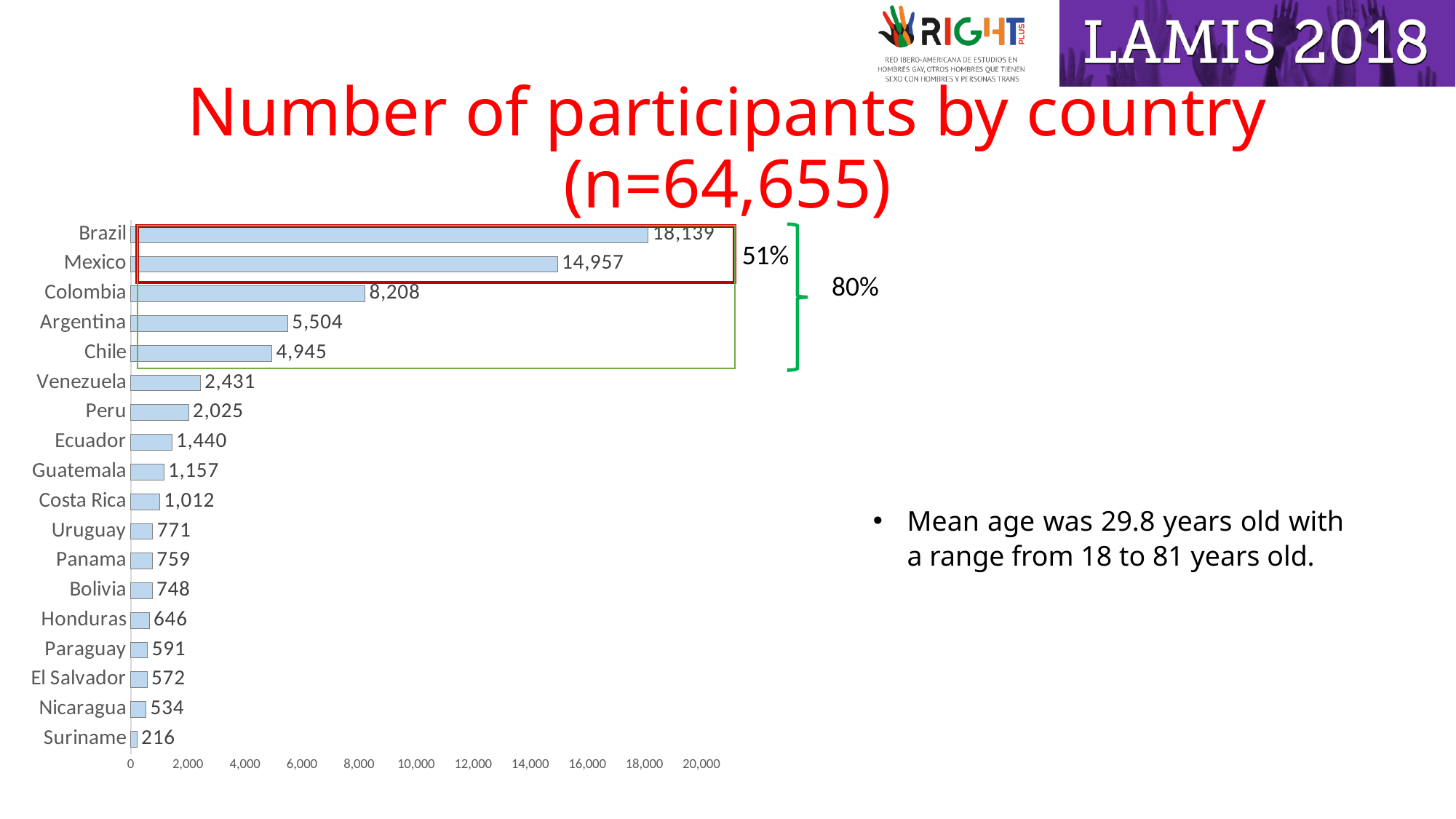
What is the number of participants for Colombia? 8,208 What is the difference in participants between Brazil and Mexico? 3,182 Which country has the lowest number of participants? Suriname What value is shown for Guatemala? 1,157 Which country has the highest number of participants? Brazil How many participants are shown for Brazil? 18,139 What percentage label is shown next to the red box around Brazil and Mexico? 51% Which has more participants, Venezuela or Peru? Venezuela How many countries are shown in the chart? 18 What is the difference in participants between Argentina and Chile? 559 What kind of chart is shown on the slide? Bar chart Is the value for Mexico greater or less than 14,000? greater